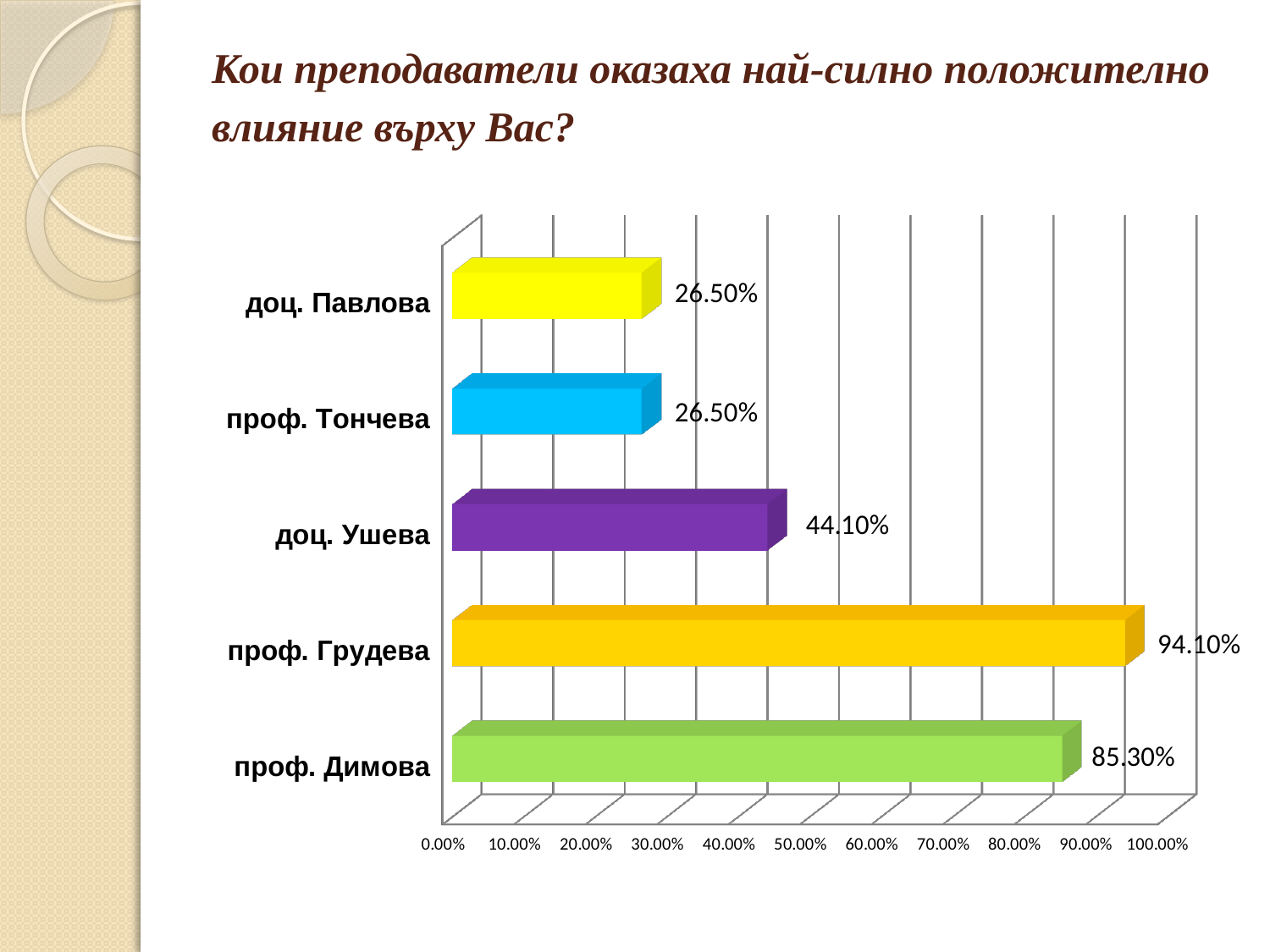
What is the value for проф. Тончева? 26.50% Which is larger, the value for доц. Ушева or the value for проф. Димова? проф. Димова What kind of chart is shown on the slide? bar chart Which category has the highest value? проф. Грудева What is the value for проф. Грудева? 94.10% Is the value for доц. Ушева greater or less than 50.00%? less What is the value for проф. Димова? 85.30% How many categories are shown in the chart? 5 What is the value for доц. Ушева? 44.10% What is the difference between the values for проф. Грудева and проф. Димова? 8.80% What colour is the bar for проф. Тончева? blue What is the difference between the values for доц. Ушева and доц. Павлова? 17.60%